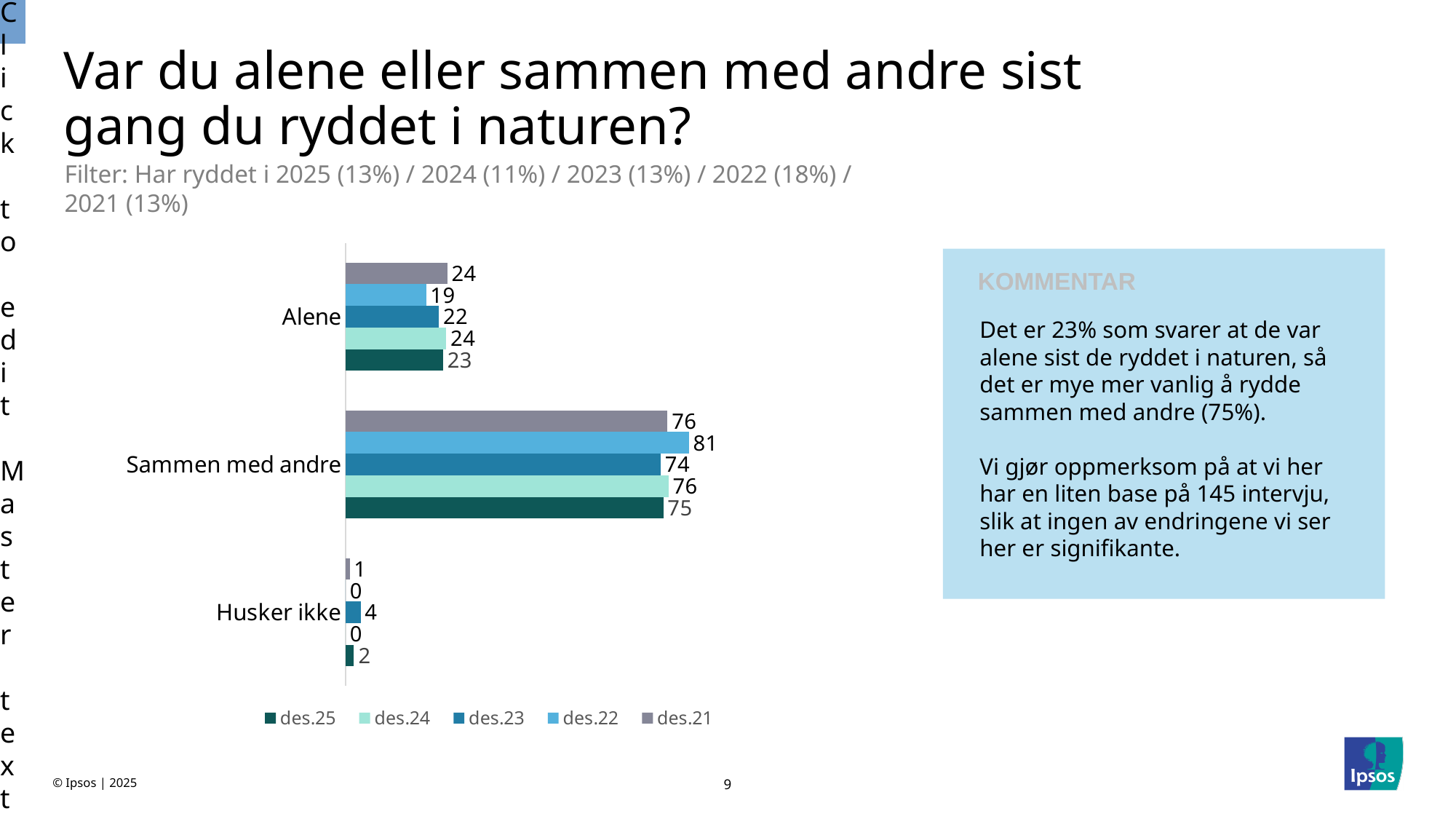
Which category has the highest value in the des.25 series? Sammen med andre Which series is shown in the darkest teal colour in the legend? des.25 Which category has the lowest value in the des.21 series? Husker ikke What kind of chart is shown on the slide? Bar chart What is the value for Alene in the des.22 series? 19 What is the value for Alene in the des.25 series? 23 What is the difference between the des.22 and des.23 values for Sammen med andre? 7 How many categories are shown on the chart? 3 Which is larger for Alene: the des.21 value or the des.22 value? des.21 What is the value for Husker ikke in the des.23 series? 4 How many series does the legend list? 5 What is the value for Sammen med andre in the des.22 series? 81